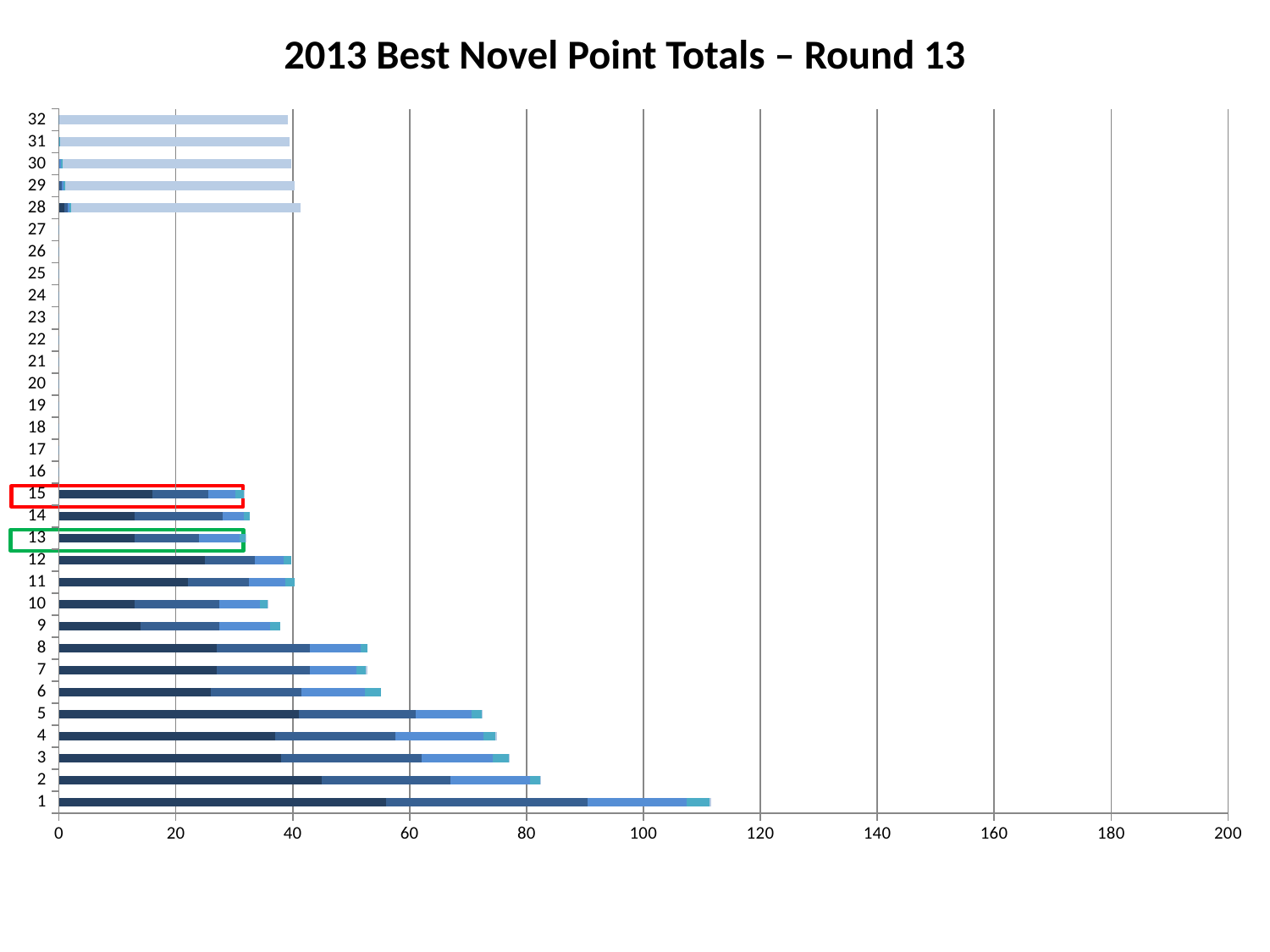
Which has the larger total, category 5 or category 8? 5 Which has the larger total, category 1 or category 2? 1 Is the value for category 2 greater or less than 100? less How many categories are listed on the vertical axis of the chart? 32 Is the value for category 5 greater or less than 80? less Which category has the longest bar in the chart? 1 Is the value for category 8 greater or less than 40? greater What is the title of the chart? 2013 Best Novel Point Totals – Round 13 What kind of chart is shown on the slide? Bar chart Which category is outlined with a red box on the chart? 15